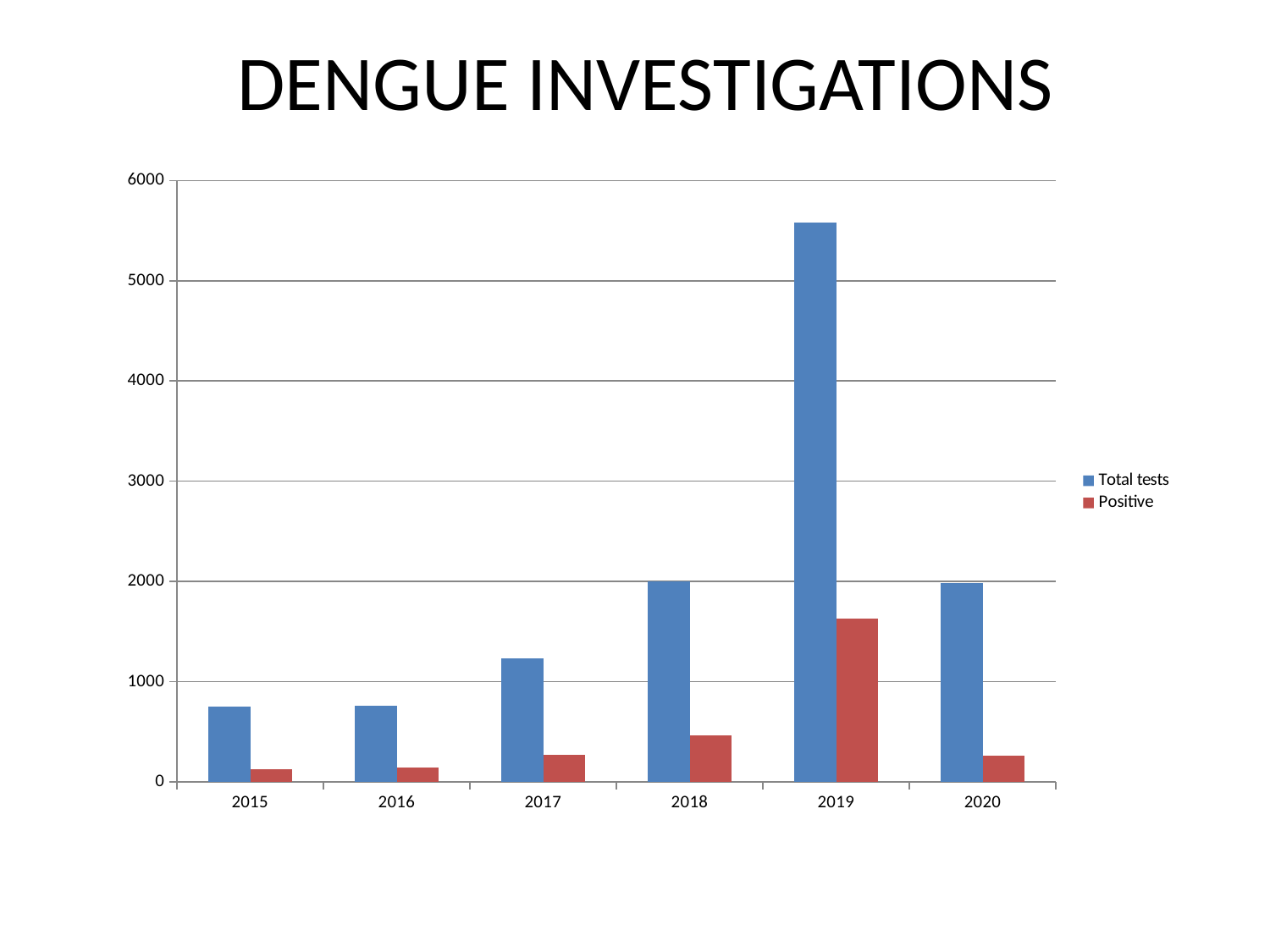
Do the Total tests values rise or fall from 2015 to 2019? rise Which is larger, Total tests in 2017 or Total tests in 2018? Total tests in 2018 Is the value for Total tests in 2019 greater or less than 5000? greater Is the value for Total tests in 2017 greater or less than 1000? greater Which year has the highest value for Positive? 2019 Is the value for Positive in 2019 greater or less than 1000? greater How many years are shown on the x axis? 6 Which year has the highest value for Total tests? 2019 How many series does the legend list? 2 What kind of chart is shown on the slide? bar chart What is the title of the slide? DENGUE INVESTIGATIONS